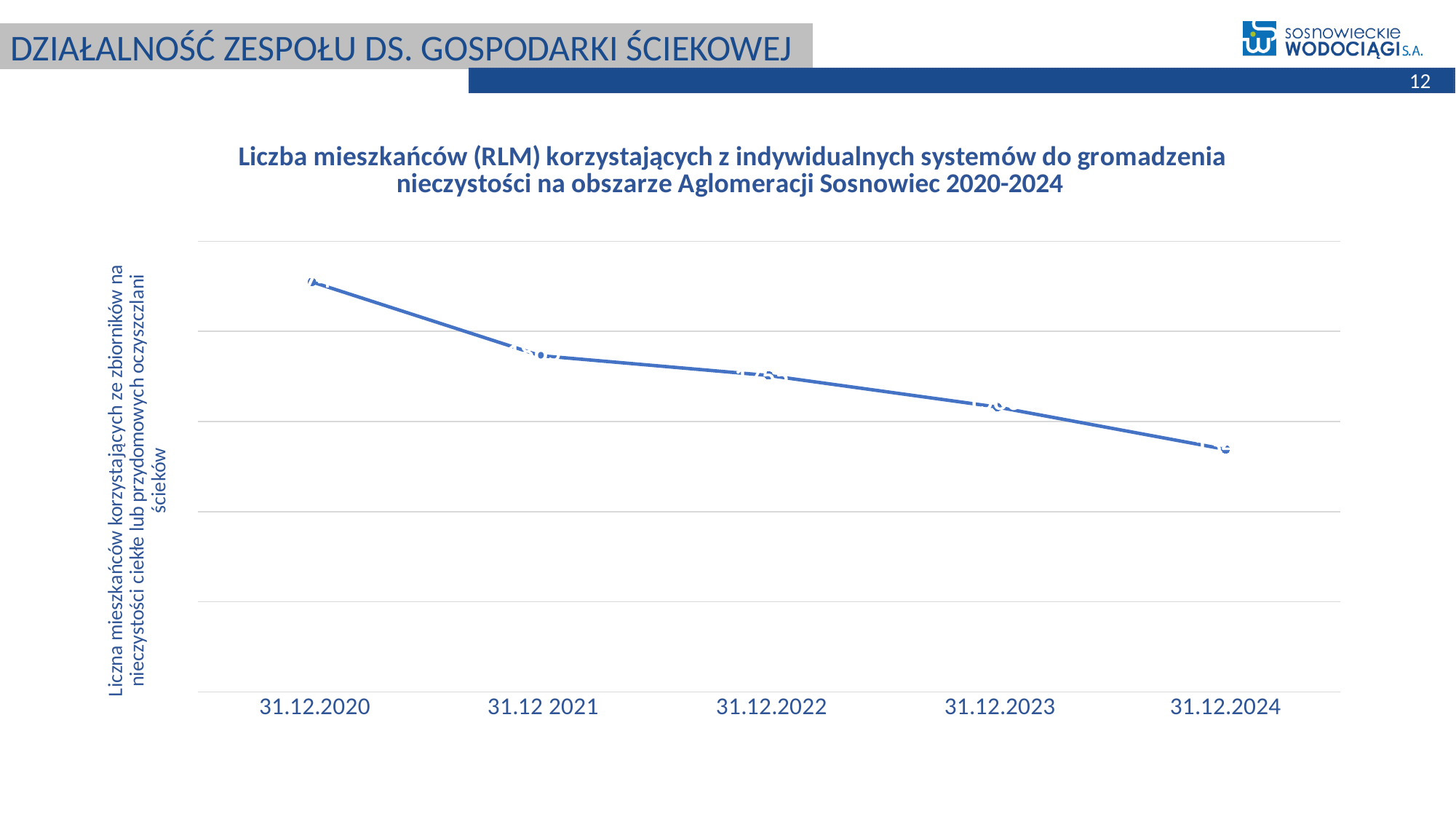
What period does the chart title say the data covers? 2020-2024 Which is larger, the value for 31.12.2020 or the value for 31.12.2022? 31.12.2020 Which date has the lowest value on the chart? 31.12.2024 How many data points are plotted on the line? 5 Which date has the highest value on the chart? 31.12.2020 Do the values rise or fall from 31.12.2020 to 31.12.2024? fall Which is larger, the value for 31.12.2021 or the value for 31.12.2023? 31.12.2021 What kind of chart is shown on the slide? line chart What is the first date shown on the x axis? 31.12.2020 Which is larger, the value for 31.12.2022 or the value for 31.12.2024? 31.12.2022